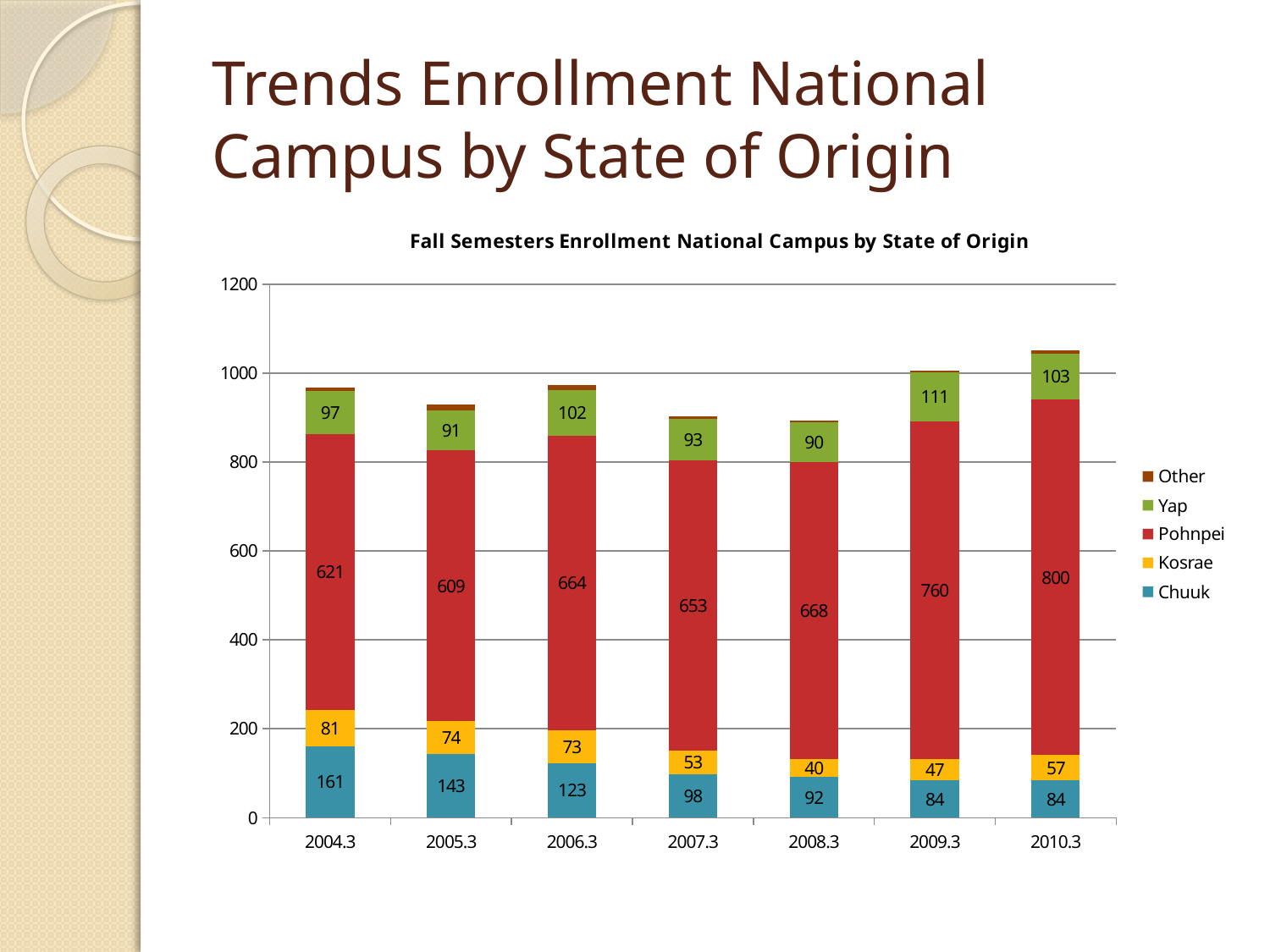
What is the Chuuk value for 2004.3? 161 Which is larger, the Chuuk value for 2005.3 or the Chuuk value for 2006.3? 2005.3 What is the Pohnpei value for 2010.3? 800 In which year is the Kosrae value lowest? 2008.3 How many series does the legend list? 5 What is the Kosrae value for 2008.3? 40 In which year is the Pohnpei value highest? 2010.3 What is the Yap value for 2009.3? 111 What is the difference between the Pohnpei values for 2010.3 and 2004.3? 179 What kind of chart is shown on the slide? Stacked bar chart How many years are shown on the x axis? 7 Is the total stacked bar for 2010.3 greater or less than 1000? greater